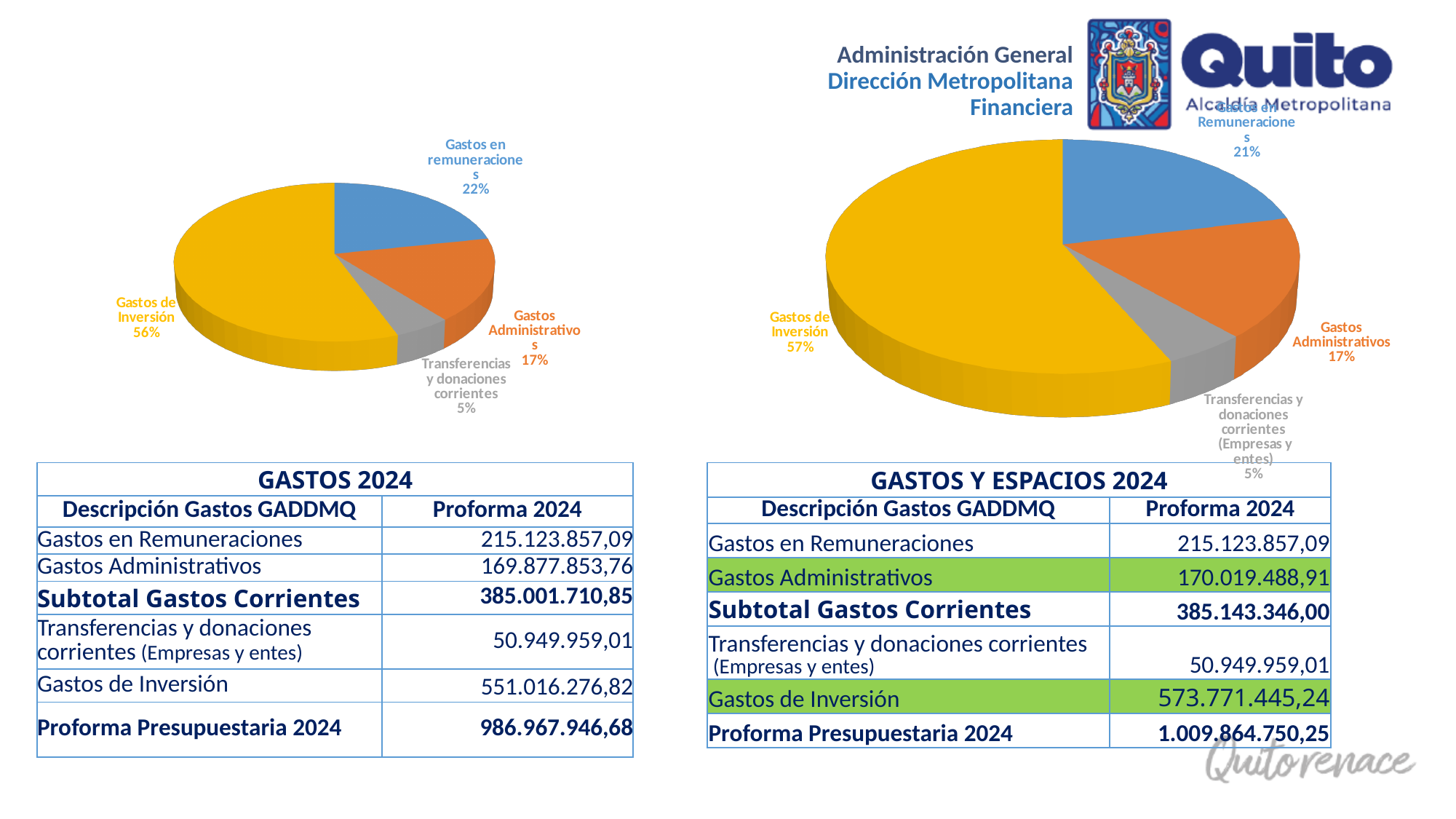
In the left pie chart, what is the difference in percentage points between Gastos de Inversión and Gastos en remuneraciones? 34 In the right pie chart, which category has the smallest slice? Transferencias y donaciones corrientes (Empresas y entes) How many slices does the left pie chart have? 4 In the left pie chart, what colour is the Gastos de Inversión slice? Yellow In the left pie chart, which category has the largest slice? Gastos de Inversión In the left pie chart, what share is labelled for Gastos de Inversión? 56% What type of chart is shown on the right side of the slide? Pie chart In the right pie chart, what percentage is shown for Gastos en Remuneraciones? 21% In the right pie chart, what percentage is labelled for Gastos Administrativos? 17% In the right pie chart, which is larger: Gastos Administrativos or Gastos en Remuneraciones? Gastos en Remuneraciones In the left pie chart, what percentage is shown for Gastos en remuneraciones? 22% In the right pie chart, what share is labelled for Gastos de Inversión? 57%